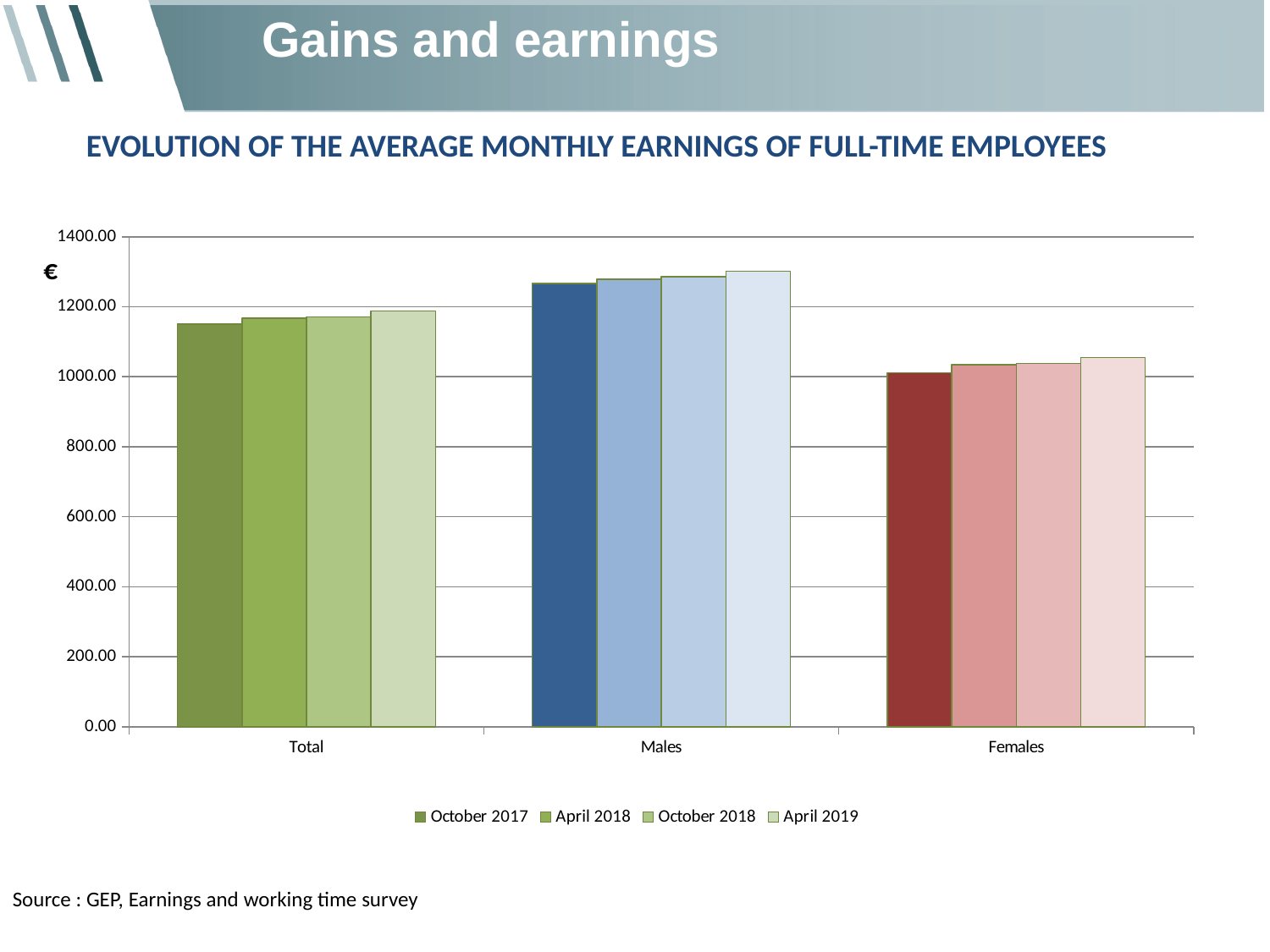
What kind of chart is shown on the slide? bar chart Is the value for Total in October 2017 greater or less than 1000.00? greater Which is larger in April 2019, the value for Males or the value for Females? Males How many categories are shown on the x axis? 3 Which category has the highest average monthly earnings in April 2019? Males Is the value for Males in April 2019 greater or less than 1200.00? greater How many series does the legend list? 4 Do the values for Males rise or fall from October 2017 to April 2019? rise Is the value for Males in October 2017 greater or less than 1400.00? less What is the title of the chart? EVOLUTION OF THE AVERAGE MONTHLY EARNINGS OF FULL-TIME EMPLOYEES Which category has the lowest average monthly earnings in October 2017? Females